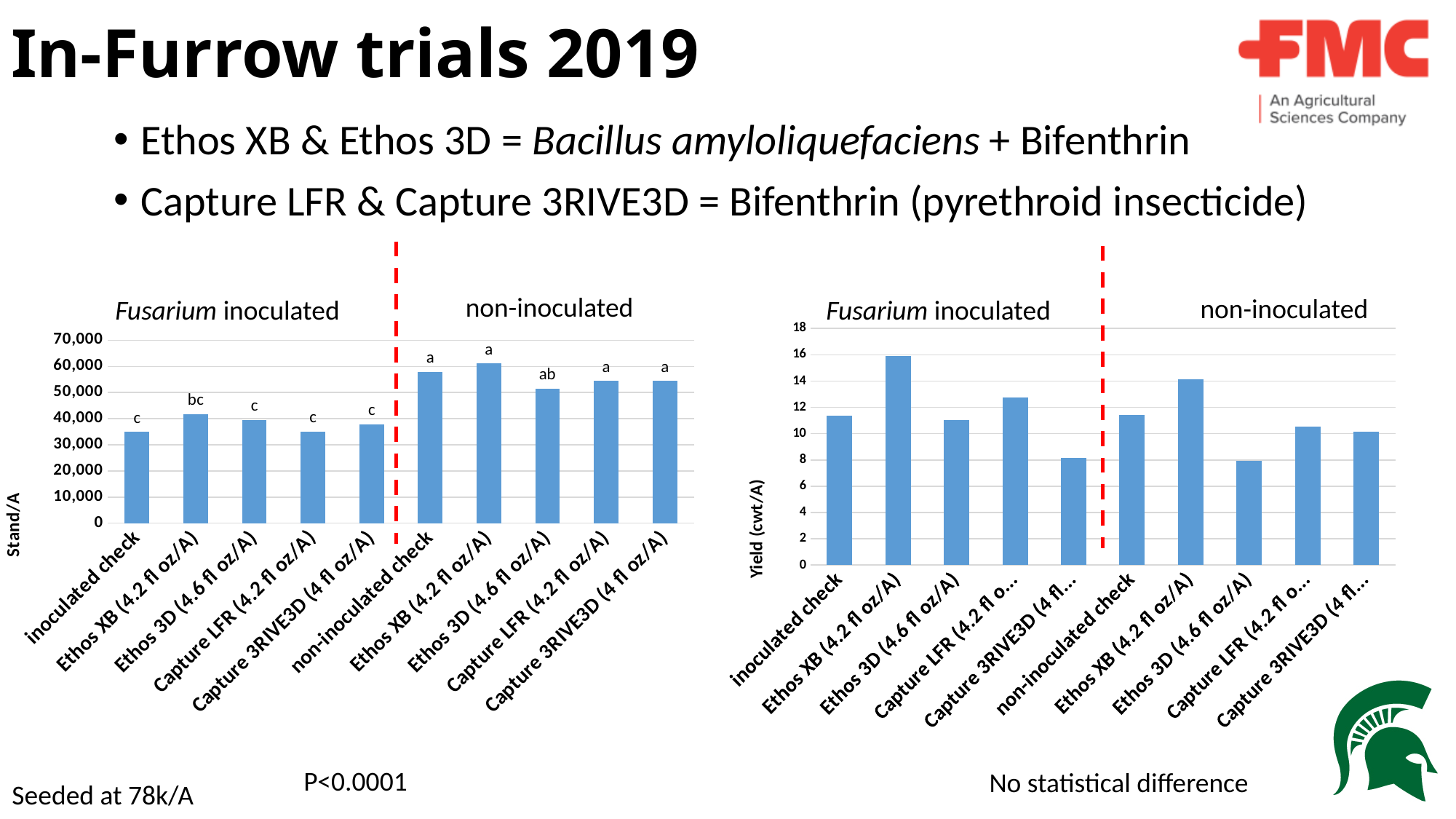
On the left chart (Stand/A), is the value for the inoculated check greater or less than 40,000? less On the left chart (Stand/A), is the value for Ethos 3D (4.6 fl oz/A) in the non-inoculated section greater or less than 50,000? greater On the right chart (Yield), is the value for Ethos XB (4.2 fl oz/A) in the non-inoculated section greater or less than 12? greater On the left chart (Stand/A), how many bars (treatments) are plotted in total? 10 On the left chart (Stand/A), in the Fusarium inoculated section, which is larger: Ethos XB (4.2 fl oz/A) or the inoculated check? Ethos XB (4.2 fl oz/A) On the left chart, what is the label of the vertical axis? Stand/A On the left chart (Stand/A), what kind of chart is shown? bar chart On the right chart (Yield), in the Fusarium inoculated section, which is larger: Capture LFR or Ethos 3D (4.6 fl oz/A)? Capture LFR On the right chart, what is the label of the vertical axis? Yield (cwt/A) On the right chart (Yield), which treatment has the highest yield? Ethos XB (4.2 fl oz/A), Fusarium inoculated On the left chart (Stand/A), which treatment has the highest stand? Ethos XB (4.2 fl oz/A), non-inoculated